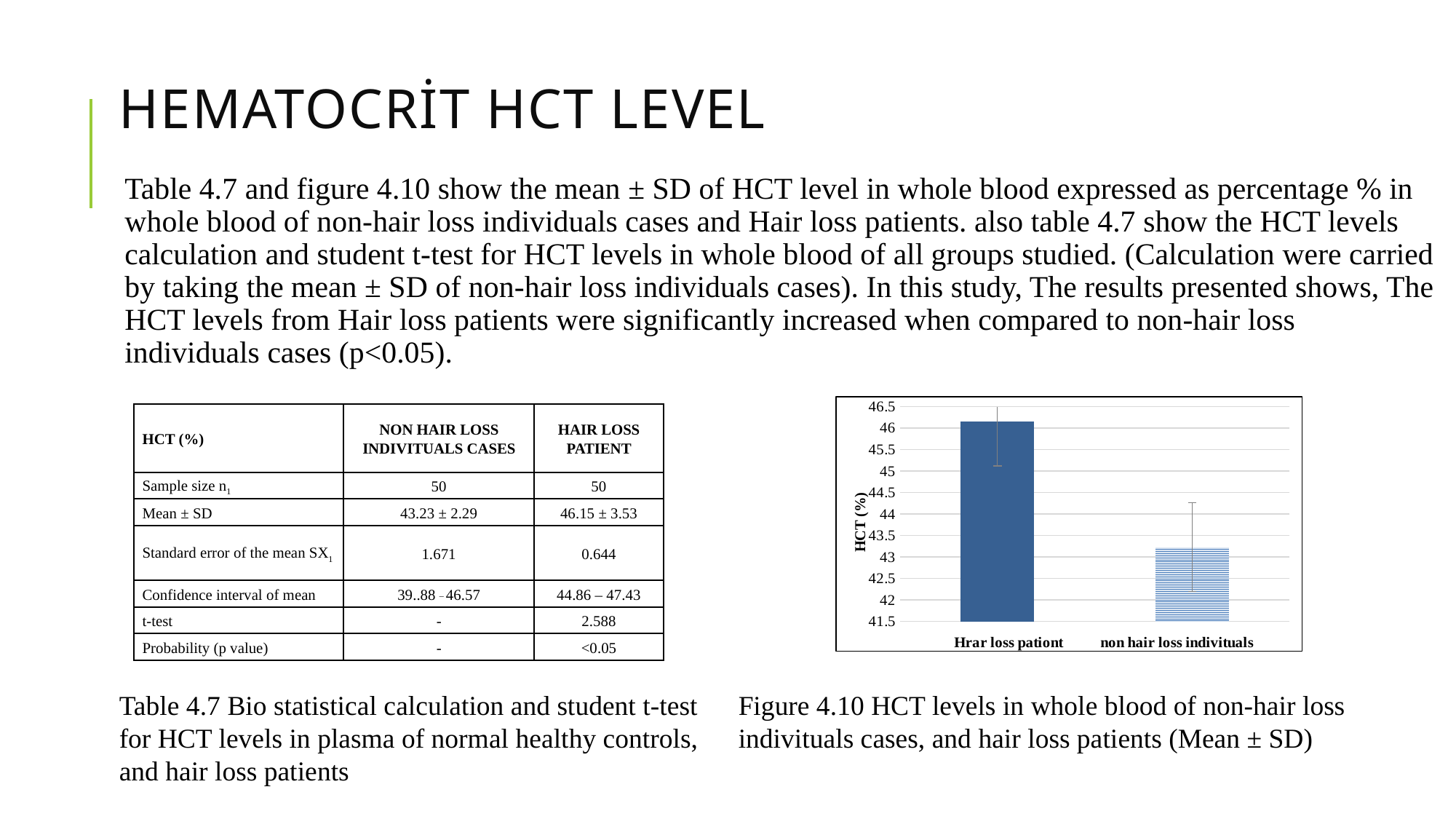
Is the value for Hrar loss pationt greater or less than 45? greater Which category has the highest HCT value in the chart? Hrar loss pationt What is the highest tick value shown on the y axis of the chart? 46.5 Which category has the lowest HCT value in the chart? non hair loss indivituals How many bars (categories) does the chart show? 2 Is the value for non hair loss indivituals greater or less than 42.5? greater Is the value for Hrar loss pationt greater or less than 46.5? less Which bar is taller, Hrar loss pationt or non hair loss indivituals? Hrar loss pationt Do the bar values rise or fall from left to right along the x axis? fall What is the label on the y axis of the chart? HCT (%) What kind of chart is shown in Figure 4.10? bar chart